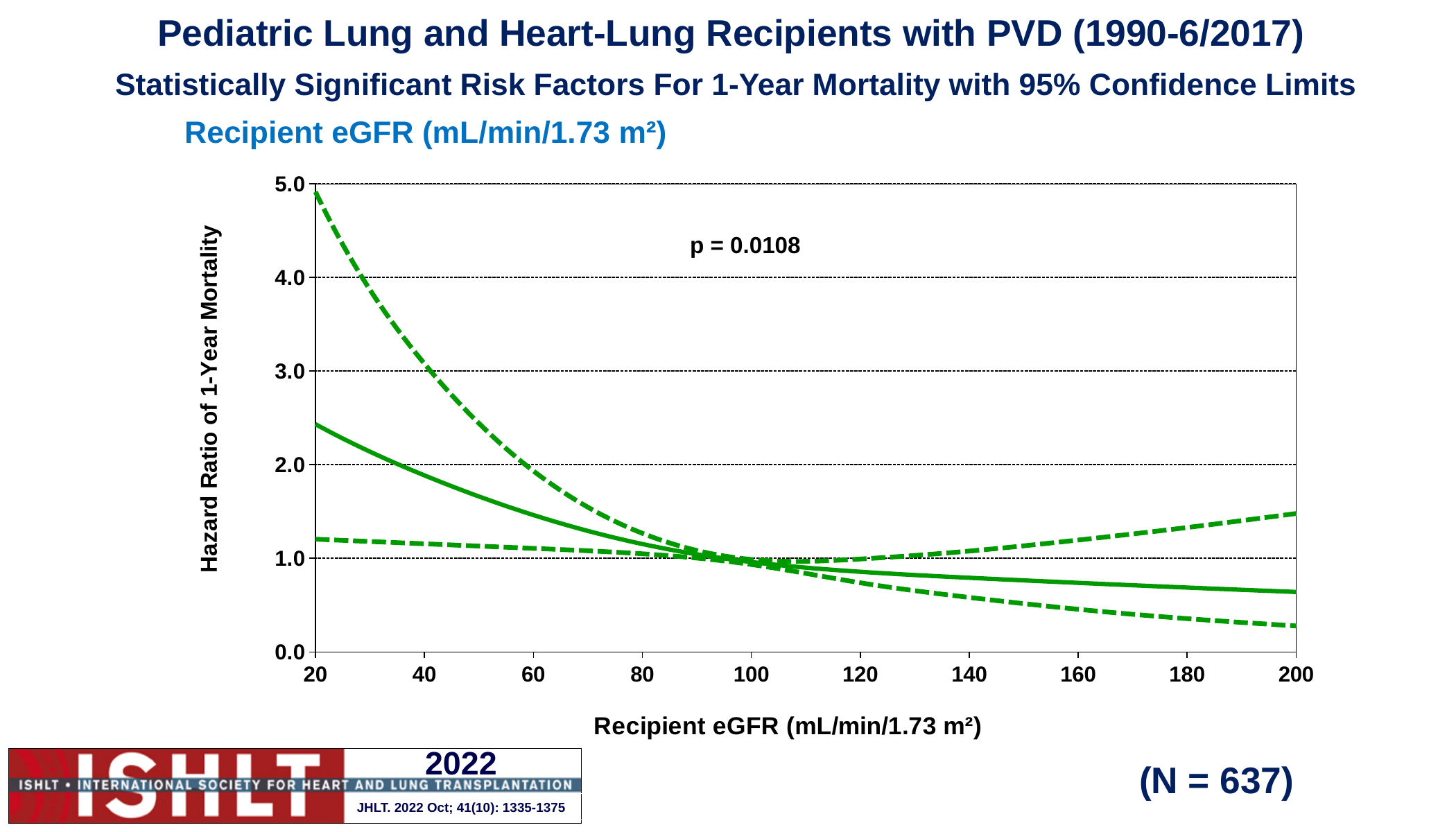
Is the hazard ratio on the solid line at a recipient eGFR of 20 greater or less than 2.0? greater What p-value is printed on the chart? p = 0.0108 What is the sample size (N) shown on the slide? N = 637 Is the hazard ratio on the solid line at a recipient eGFR of 200 greater or less than 1.0? less Is the hazard ratio on the solid line at a recipient eGFR of 60 greater or less than 1.0? greater How many lines are plotted on the chart? 3 Does the solid hazard ratio line rise or fall as recipient eGFR increases from 20 to 200? fall What kind of chart is shown on the slide? line chart On the solid line, is the hazard ratio larger at a recipient eGFR of 20 or at 200? 20